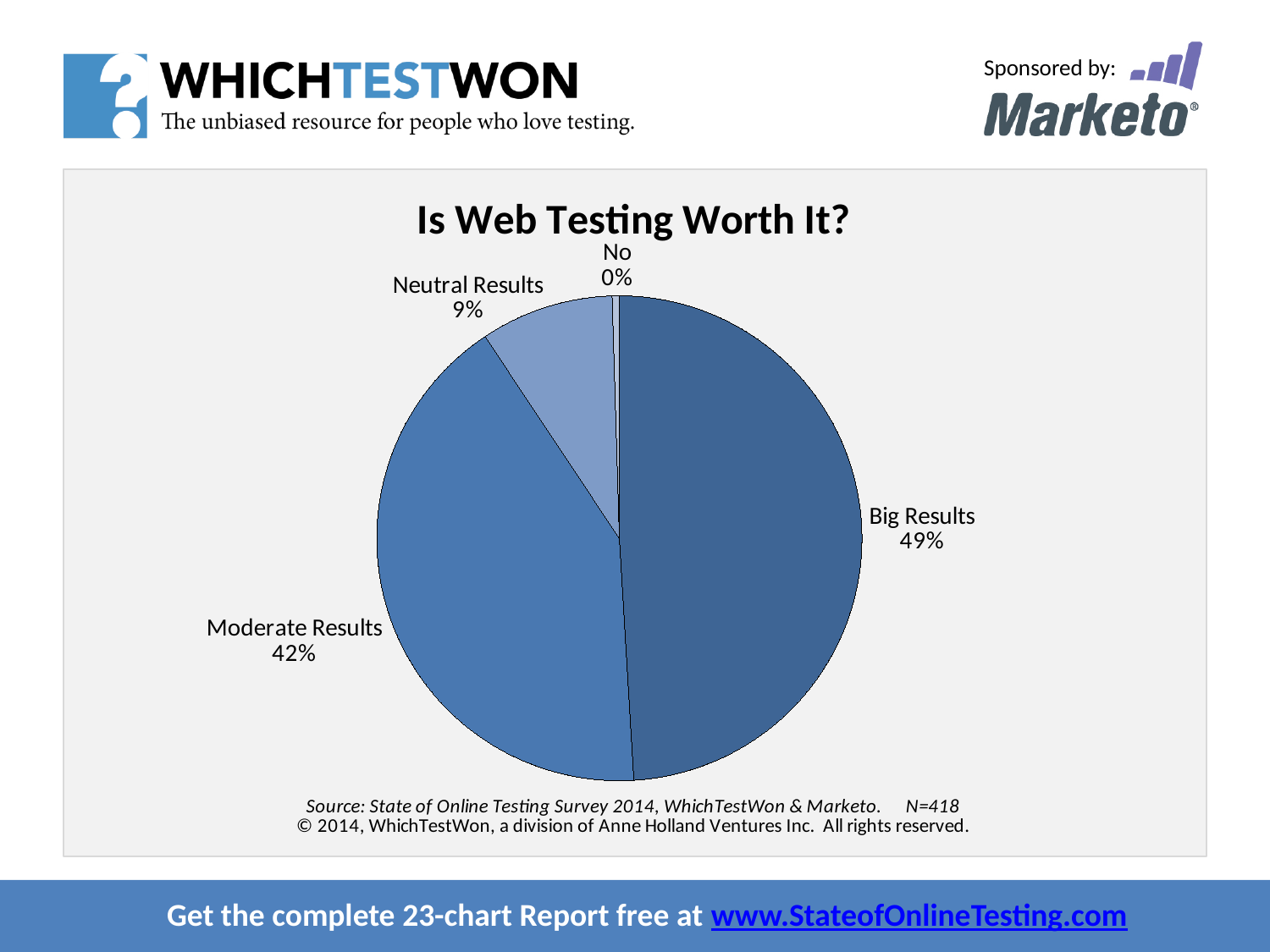
How many categories are shown in the pie chart? 4 Which category has the largest share of the pie? Big Results Which category has the smallest share of the pie? No What is the title of the chart? Is Web Testing Worth It? What kind of chart is shown on the slide? Pie chart Which is larger, the share for Moderate Results or the share for Neutral Results? Moderate Results What is the difference in percentage points between Big Results and Moderate Results? 7 percentage points What percentage of respondents reported Big Results? 49% What percentage of respondents reported Moderate Results? 42% What percentage of respondents reported Neutral Results? 9% What percentage is shown for the "No" slice? 0% What is the sample size (N) stated in the source note below the chart? N=418